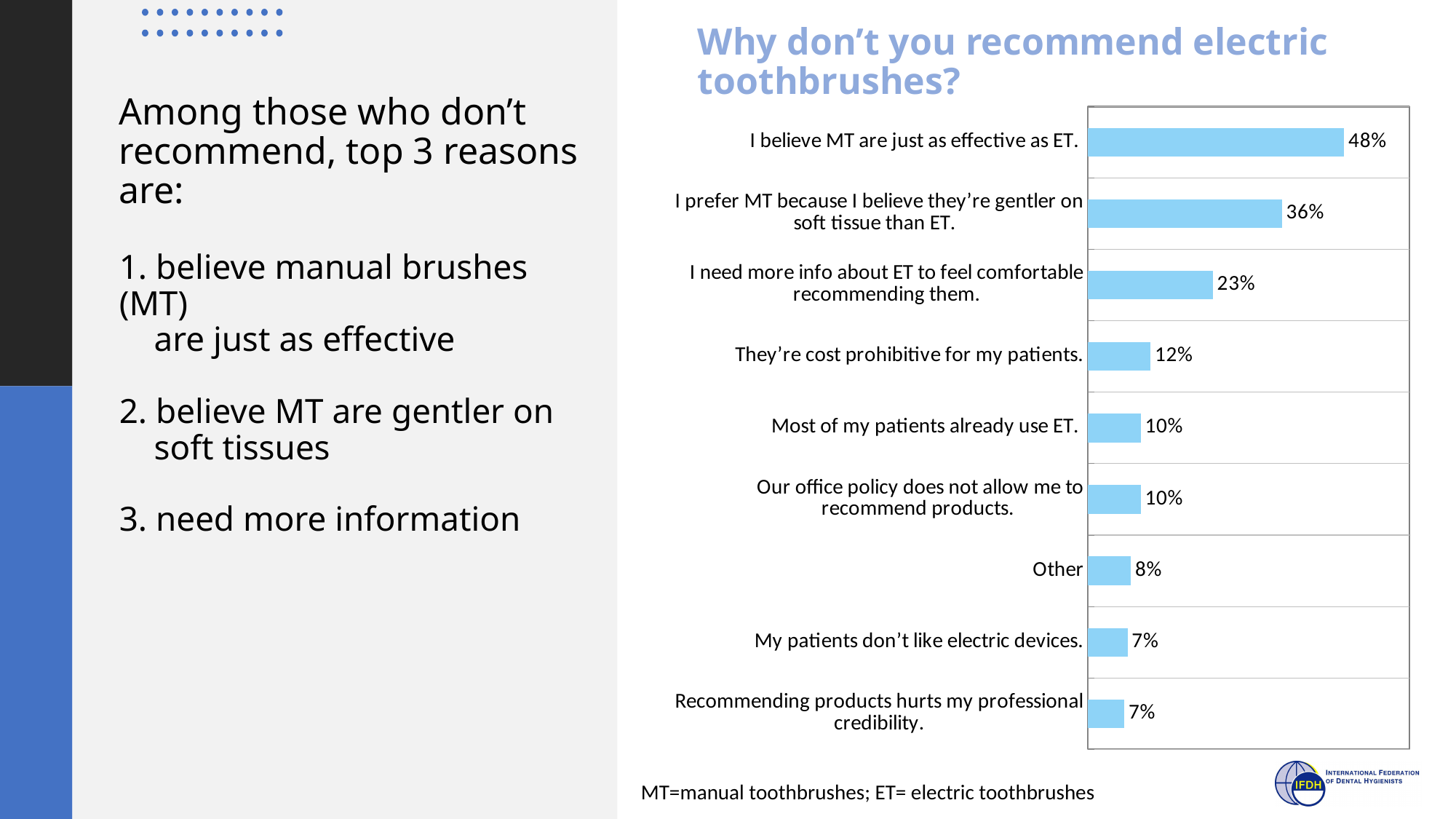
What colour are the bars in the chart? Light blue What is the value for 'Other'? 8% What is the title of the chart? Why don't you recommend electric toothbrushes? What is the difference between 'I believe MT are just as effective as ET.' and 'I prefer MT because I believe they're gentler on soft tissue than ET.'? 12% What is the value for 'They're cost prohibitive for my patients.'? 12% What is the difference between 'I need more info about ET to feel comfortable recommending them.' and 'They're cost prohibitive for my patients.'? 11% What percentage chose 'I need more info about ET to feel comfortable recommending them.'? 23% Which reason has the highest percentage? I believe MT are just as effective as ET. Which is larger: 'Most of my patients already use ET.' or 'Other'? Most of my patients already use ET. How many reasons (categories) are shown in the chart? 9 What percentage of respondents said they believe MT are just as effective as ET? 48% What kind of chart is shown on the slide? Bar chart